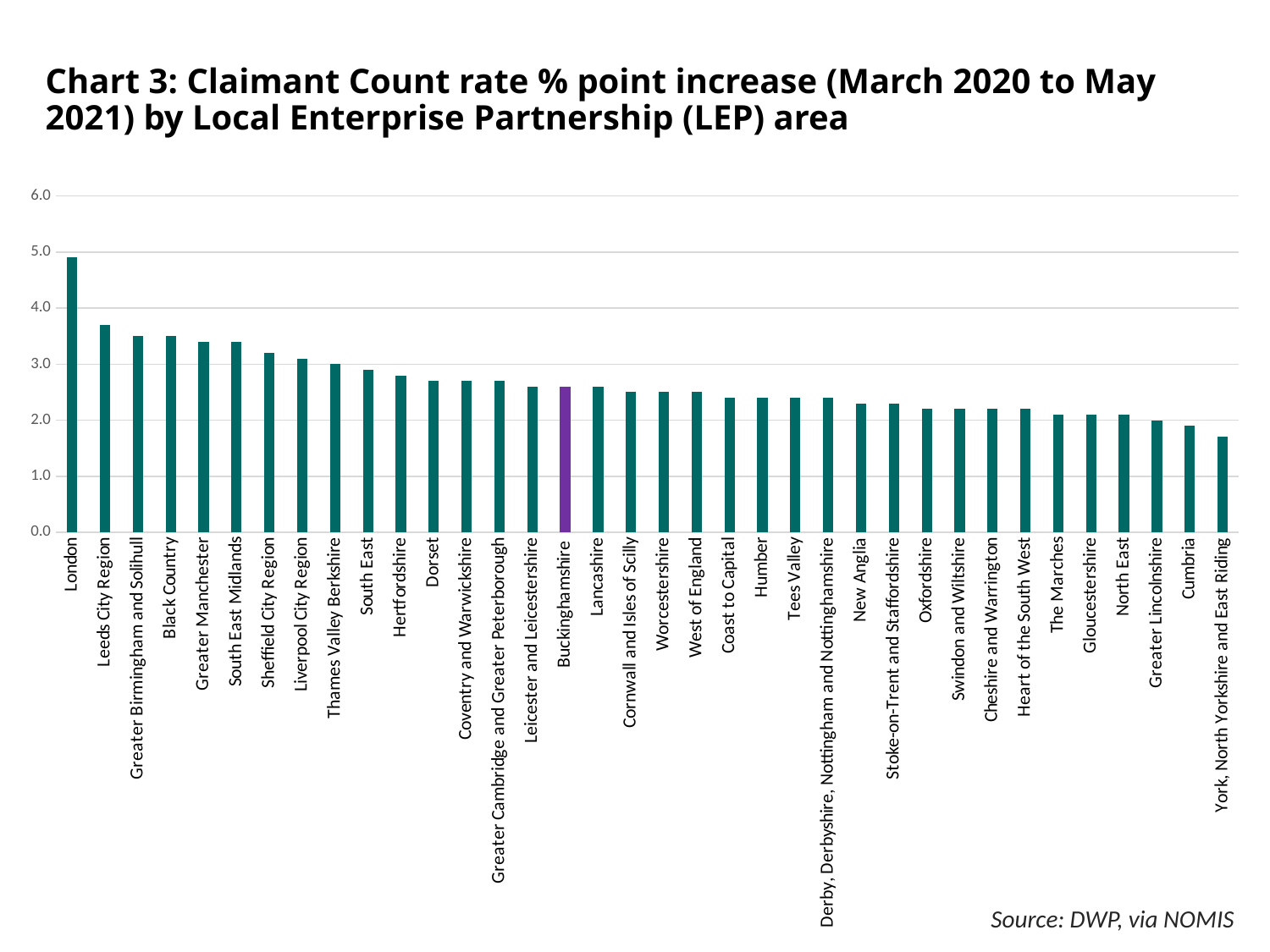
Is the value for London greater or less than 4.0? greater Do the bar values rise or fall moving from left to right along the x axis? Fall Which LEP area's bar is highlighted in purple rather than green? Buckinghamshire Is the value for Oxfordshire greater or less than 3.0? less Which has the larger % point increase, London or Leeds City Region? London Is the value for Leeds City Region greater or less than 3.0? greater Which LEP area has the lowest Claimant Count rate % point increase? York, North Yorkshire and East Riding Which has the larger % point increase, Black Country or Cumbria? Black Country Which LEP area has the highest Claimant Count rate % point increase? London What kind of chart is shown on the slide? Bar chart How many LEP areas are plotted on the chart? 36